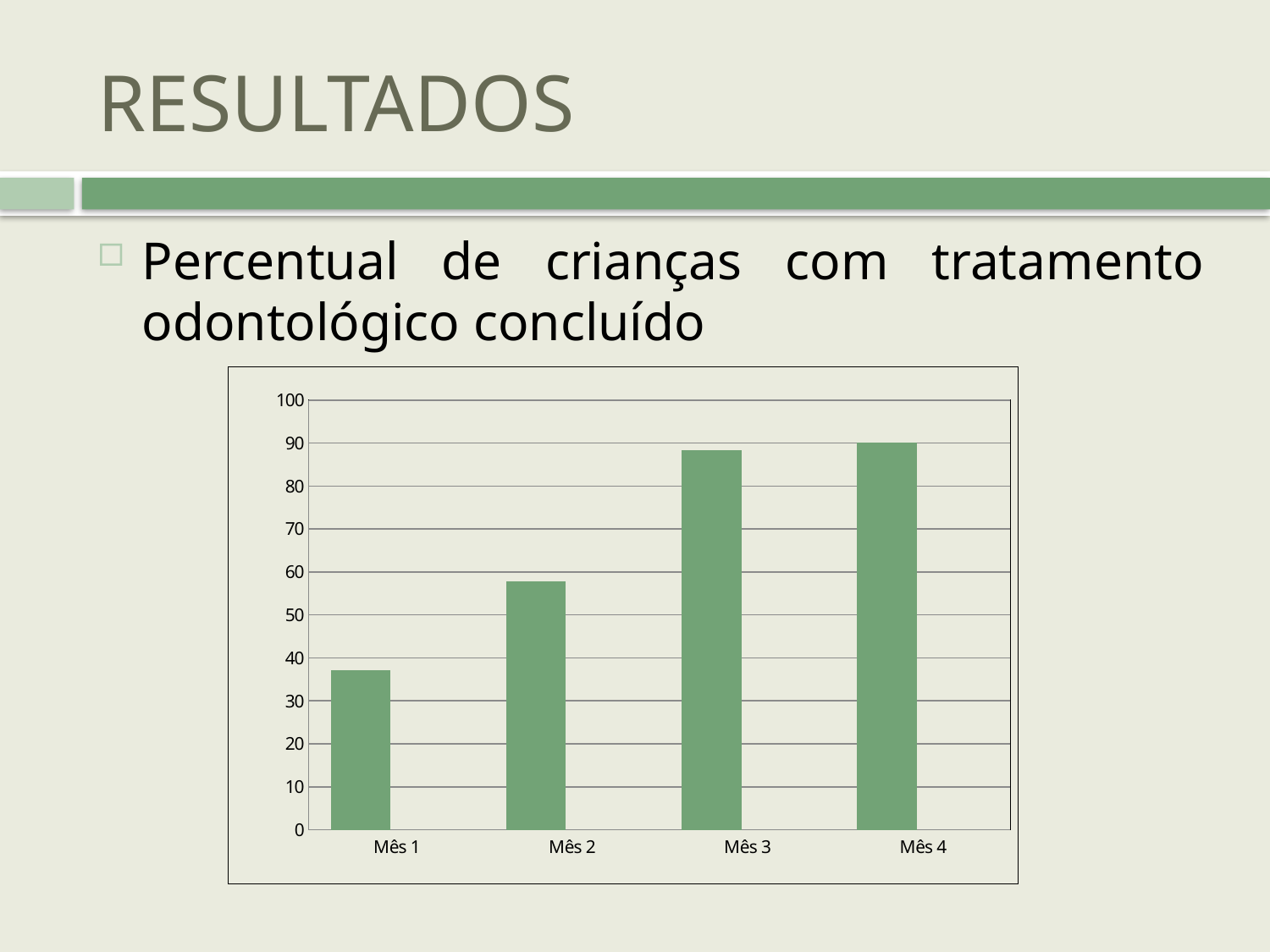
What colour are the bars in the chart? green Is the value for Mês 3 greater or less than 80? greater Is the value for Mês 2 greater or less than 60? less Which is larger, the value for Mês 1 or the value for Mês 2? Mês 2 Is the value for Mês 1 greater or less than 40? less What kind of chart is shown on the slide? bar chart How many categories (months) are shown on the x axis of the chart? 4 Which month has the lowest value in the chart? Mês 1 Do the values rise or fall from Mês 1 to Mês 4? rise